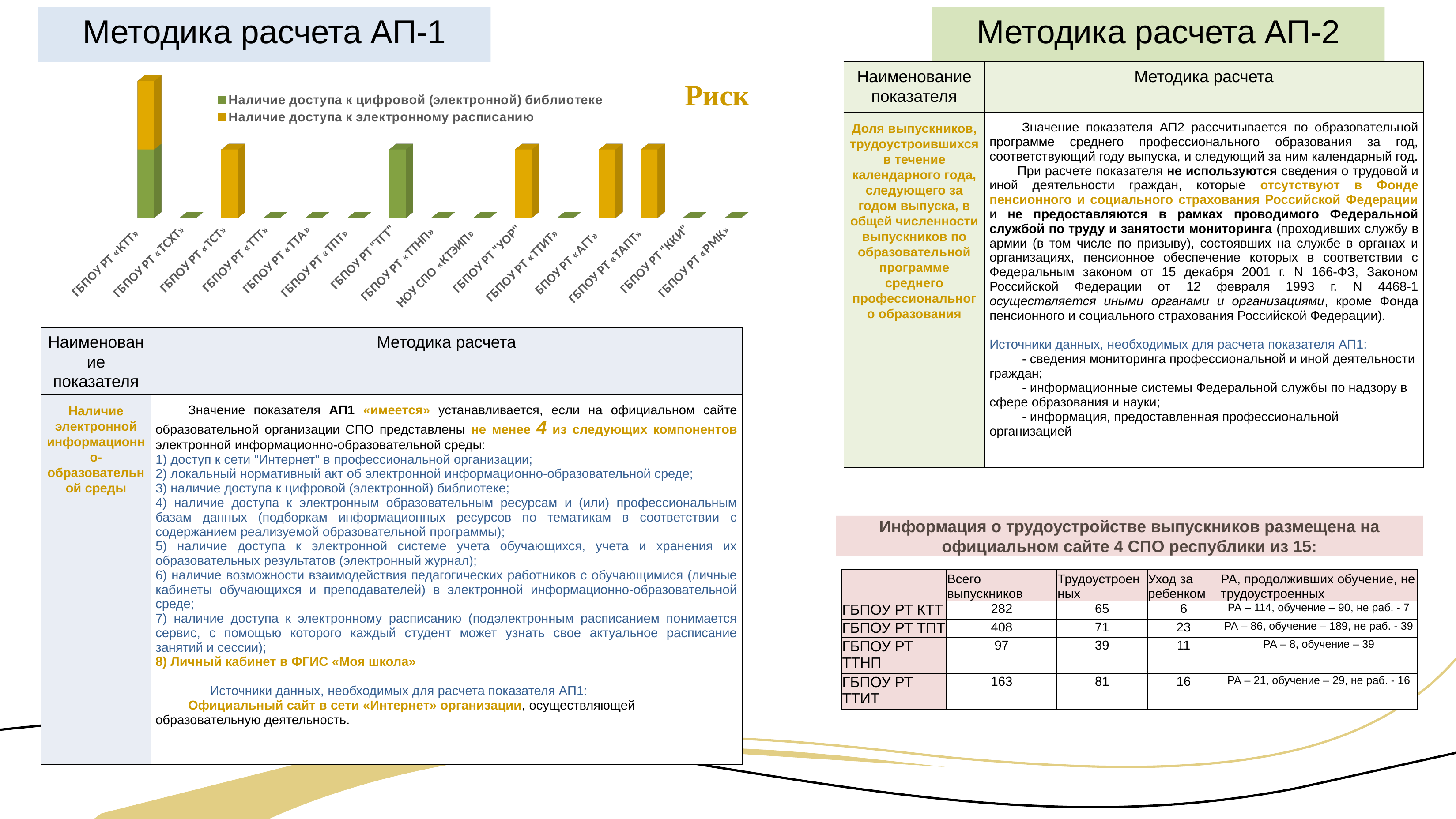
What is the name of the first series listed in the chart legend? Наличие доступа к цифровой (электронной) библиотеке Which category has the tallest bar in the chart? ГБПОУ РТ «КТТ» Which is larger in the chart: the bar for ГБПОУ РТ "УОР" or the bar for НОУ СПО «КТЭИП»? ГБПОУ РТ "УОР" How many series does the chart legend list? 2 How many categories (institutions) are shown along the x axis of the chart? 15 What colour represents the series «Наличие доступа к электронному расписанию» in the chart? Yellow (gold) Which is larger in the chart: the bar for ГБПОУ РТ «КТТ» or the bar for ГБПОУ РТ «ТСХТ»? ГБПОУ РТ «КТТ» Which is larger in the chart: the bar for ГБПОУ РТ «ТСТ» or the bar for ГБПОУ РТ «ТТА»? ГБПОУ РТ «ТСТ» What kind of chart is shown on the slide? Stacked bar chart Which category is the only one whose bar contains both series in the chart? ГБПОУ РТ «КТТ»